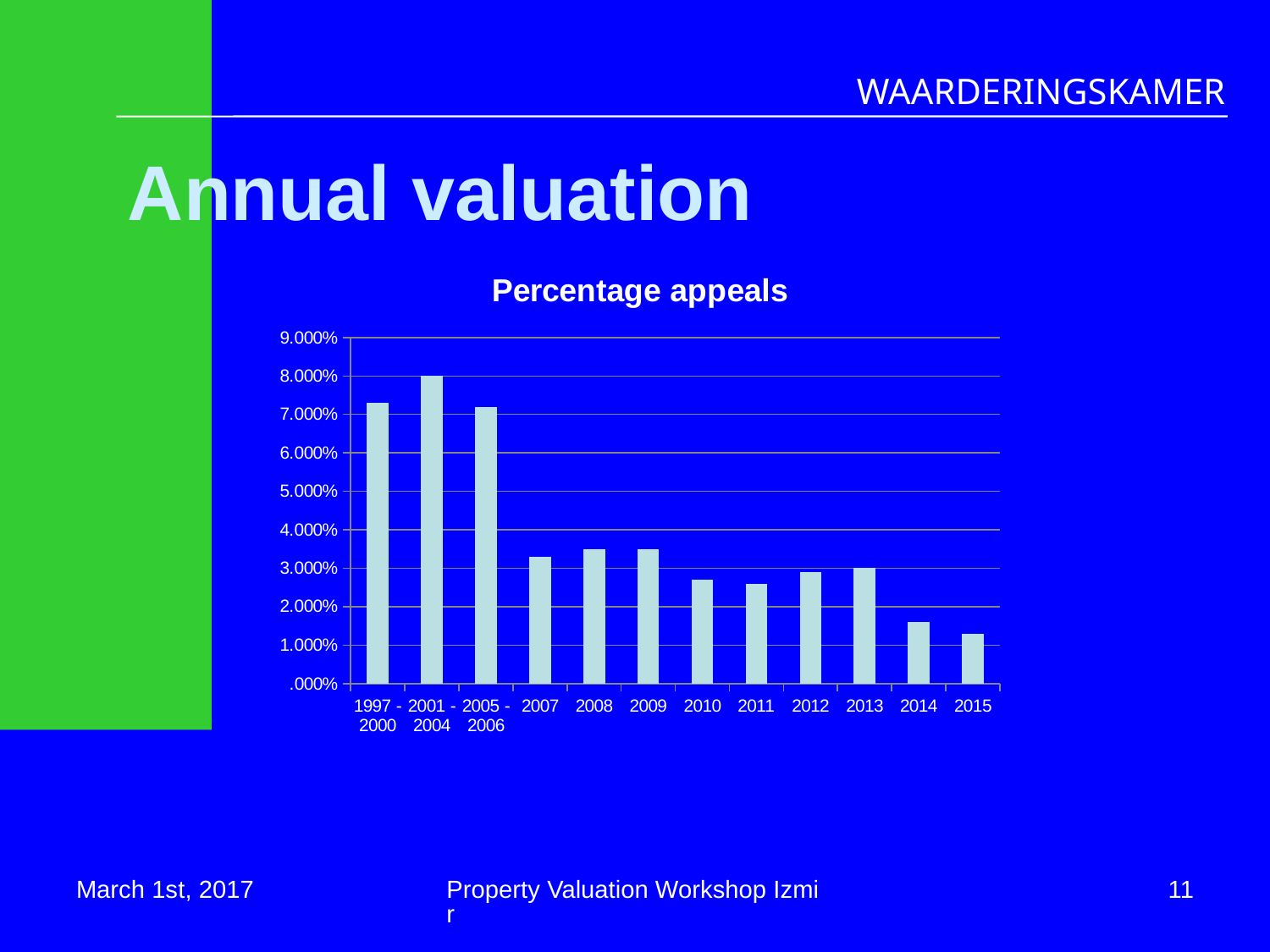
Do the values generally rise or fall from left to right along the x axis? fall Is the value for 2007 greater or less than 4.000%? less What is the title of the chart? Percentage appeals How many categories are shown on the x axis of the chart? 12 Which is larger, the value for 2005 - 2006 or the value for 2008? 2005 - 2006 Which is larger, the value for 2013 or the value for 2015? 2013 Which category has the highest percentage of appeals? 2001 - 2004 Which category has the lowest percentage of appeals? 2015 Is the value for 2010 greater or less than 2.000%? greater What kind of chart is shown on the slide? bar chart Is the value for 1997 - 2000 greater or less than 7.000%? greater